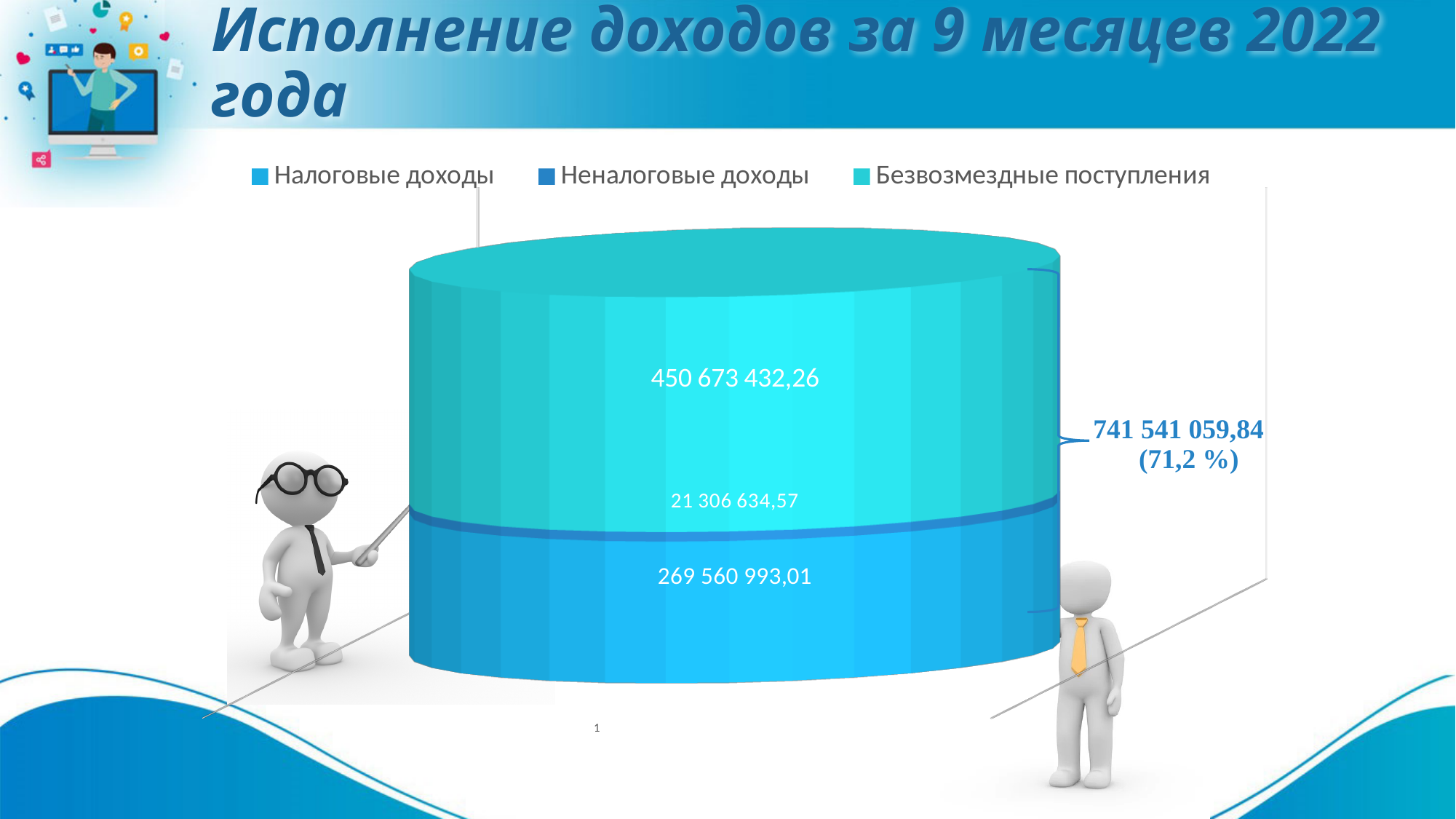
What percentage is shown next to the total of the bar? 71,2 % Which is larger, Налоговые доходы or Безвозмездные поступления? Безвозмездные поступления What kind of chart is shown on the slide? Stacked bar chart What is the title of the slide? Исполнение доходов за 9 месяцев 2022 года Which series has the largest value? Безвозмездные поступления What is the total of the stacked bar? 741 541 059,84 What is the difference between Безвозмездные поступления and Налоговые доходы? 181 112 439,25 What is the value for Налоговые доходы? 269 560 993,01 How many series does the legend list? 3 Which series has the smallest value? Неналоговые доходы What is the value for Безвозмездные поступления? 450 673 432,26 What is the value for Неналоговые доходы? 21 306 634,57